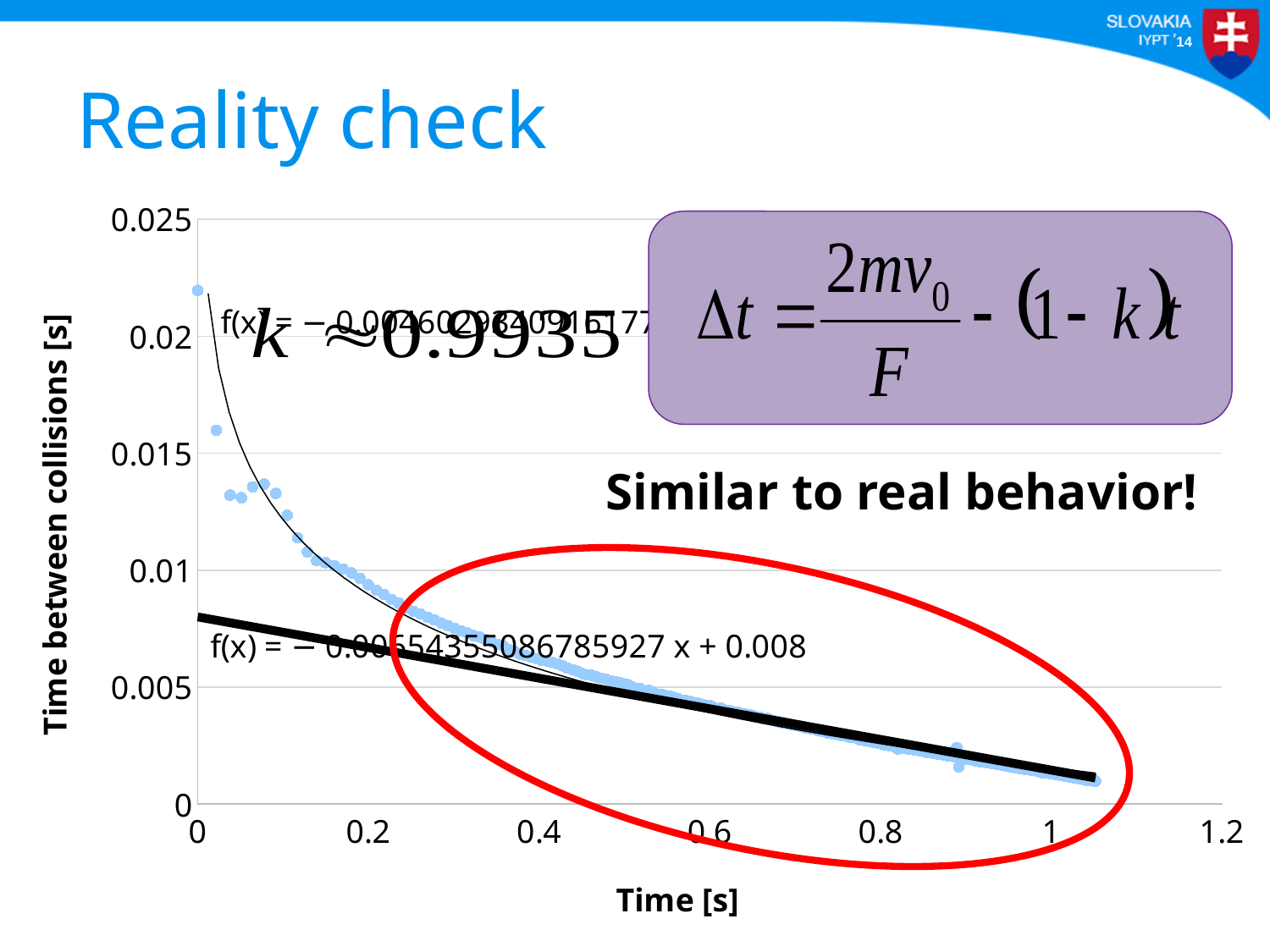
Which has a larger time between collisions, the point at time 0 or the point at time 0.8? the point at time 0 What is the label of the x axis of the chart? Time [s] Do the plotted values rise or fall as time increases along the x axis? fall What is the y-intercept of the linear fit f(x) shown on the chart? 0.008 Is the time between collisions at time 0.2 greater or less than 0.005? greater Is the time between collisions at time 1 greater or less than 0.005? less What is the highest value shown on the x axis of the chart? 1.2 Is the time between collisions at time 0 greater or less than 0.02? greater What is the label of the y axis of the chart? Time between collisions [s] What kind of chart is shown on the slide? scatter chart